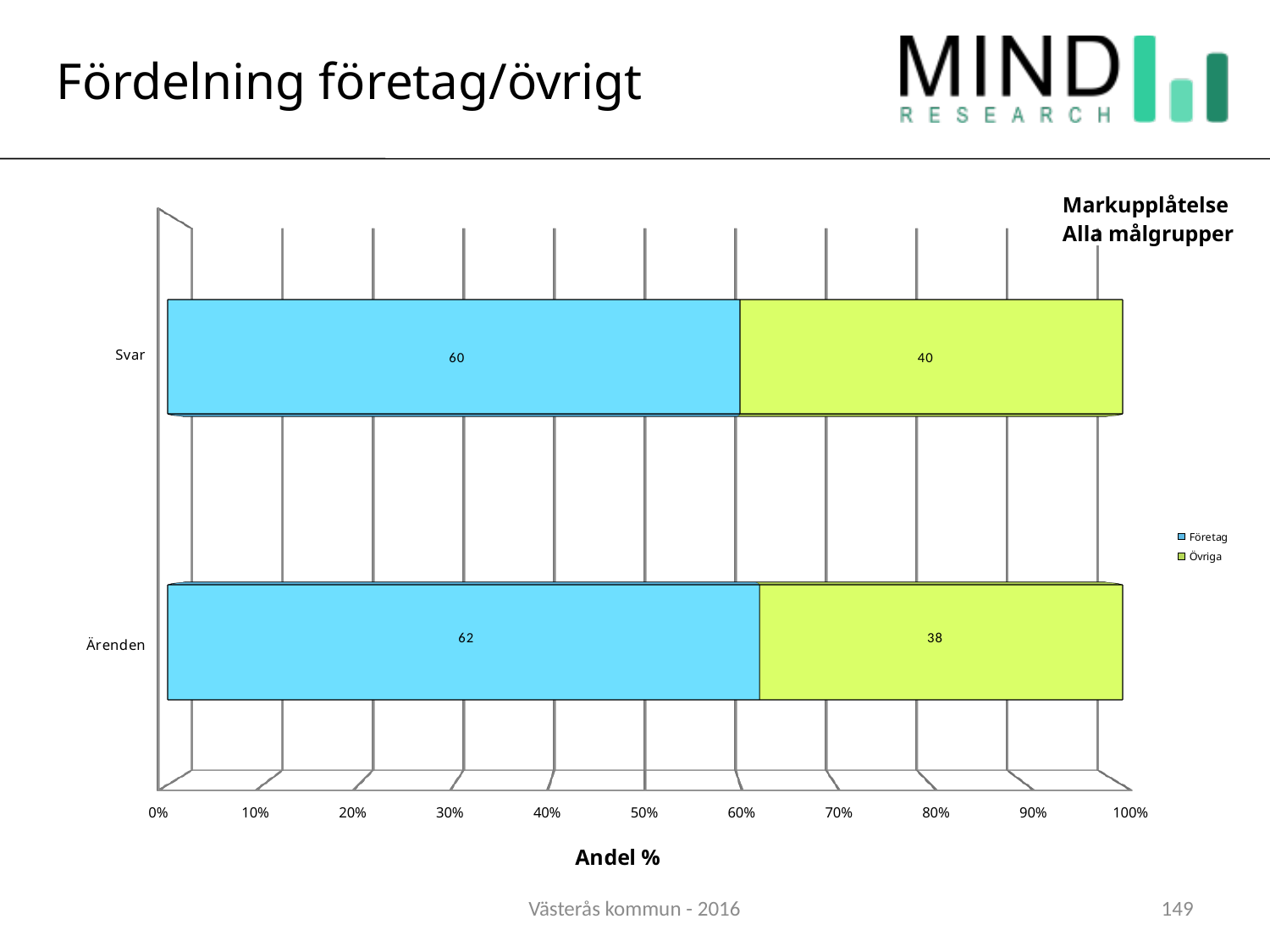
How many series does the legend list? 2 What is the difference between the Företag values for Ärenden and Svar? 2 What is the Företag value for Ärenden? 62 Which category has the lower Övriga value? Ärenden Which category has the higher Företag value, Svar or Ärenden? Ärenden What is the total of the stacked bar for Ärenden? 100 What is the Övriga value for Svar? 40 What is the Övriga value for Ärenden? 38 What is the Företag value for Svar? 60 How many categories are shown on the vertical axis? 2 What is the difference between the Företag and Övriga values for Svar? 20 What kind of chart is shown on the slide? Stacked bar chart